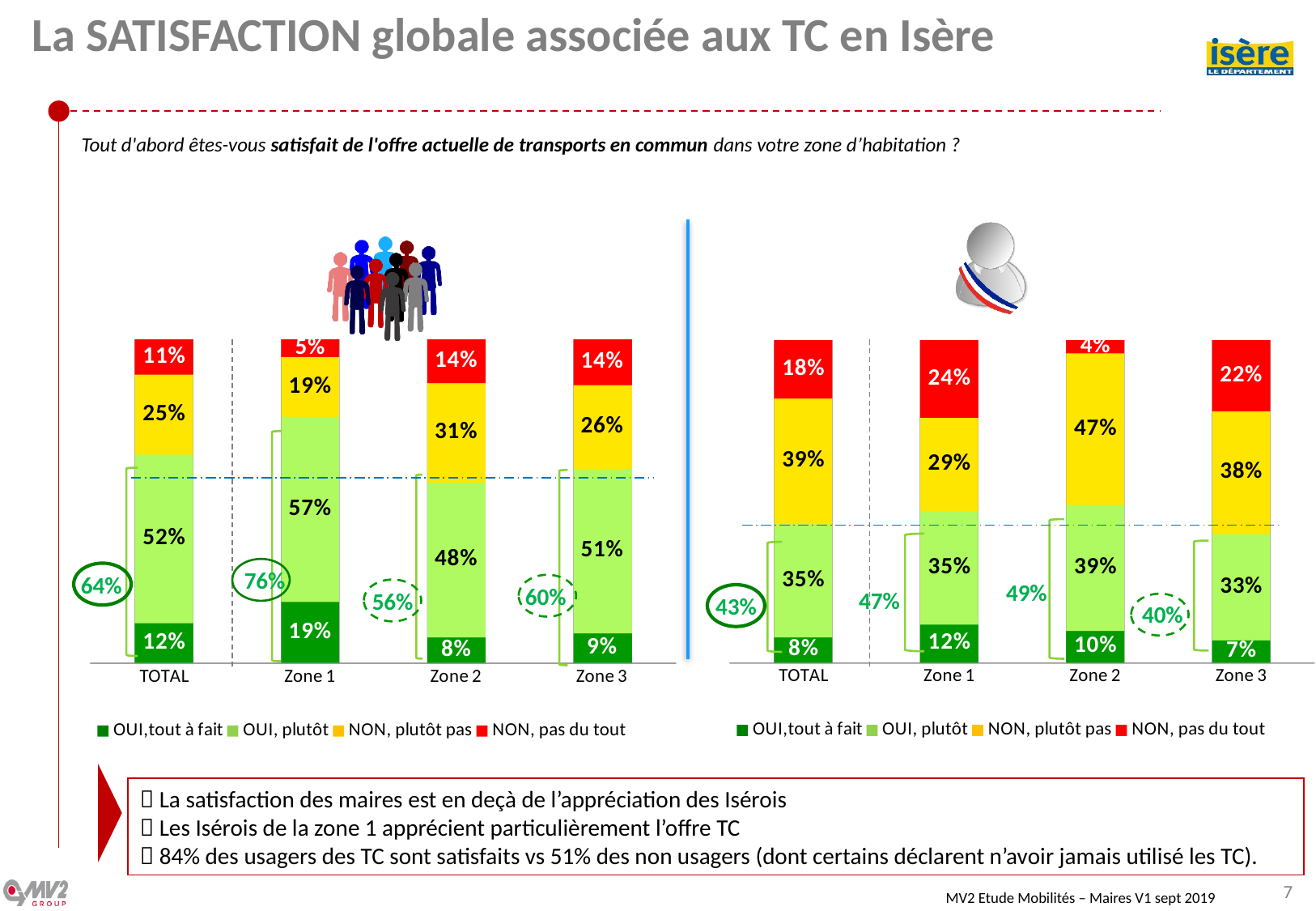
In the right chart, what is the value of "NON, plutôt pas" for Zone 2? 47% How many categories are shown on the x axis of the left chart? 4 In the left chart, which category has the highest value for "OUI, tout à fait"? Zone 1 In the left chart, is the "OUI, plutôt" value larger for Zone 2 or Zone 3? Zone 3 In the left chart, what is the value of "OUI, plutôt" for Zone 1? 57% In the right chart, which category has the lowest value for "NON, pas du tout"? Zone 2 How many series does the legend of the right chart list? 4 In the right chart, what is the difference between the "NON, plutôt pas" values for Zone 2 and Zone 1? 18% In the left chart, what is the combined total of "OUI, tout à fait" and "OUI, plutôt" for TOTAL? 64% In the left chart, what is the value of "NON, pas du tout" for TOTAL? 11% What kind of chart is the left chart? Stacked bar chart In the right chart, what is the value of "OUI, tout à fait" for Zone 3? 7%